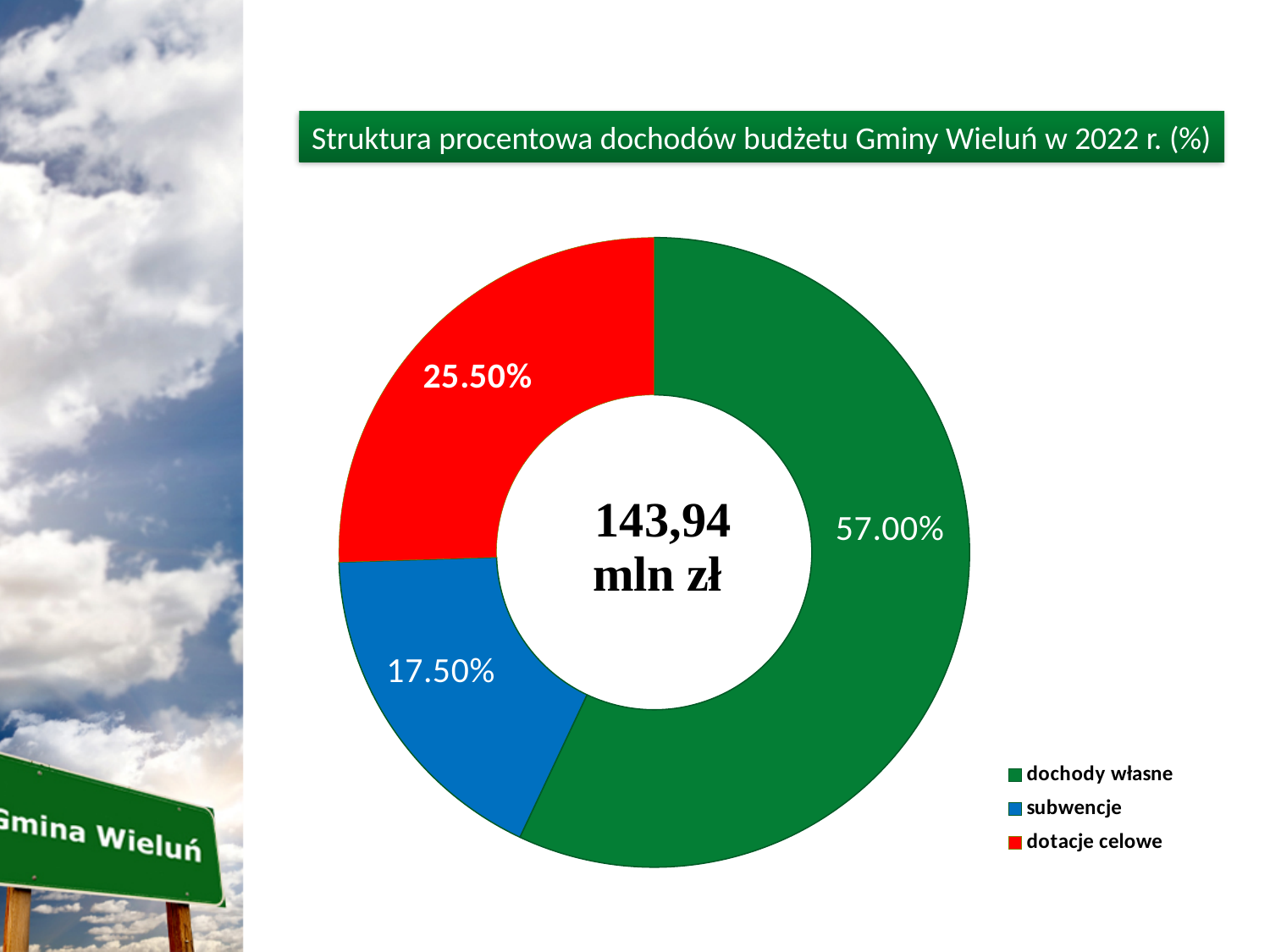
What colour represents 'subwencje' in the chart? blue Which category has the smallest share of the budget income? subwencje Which is larger: the share for 'subwencje' or for 'dotacje celowe'? dotacje celowe What is the difference in percentage points between 'dochody własne' and 'dotacje celowe'? 31.50 What kind of chart is shown on the slide? pie chart (doughnut) What share of the budget income is 'dochody własne'? 57.00% What share of the budget income is 'dotacje celowe'? 25.50% Which category has the largest share of the budget income? dochody własne What total amount is printed in the centre of the chart? 143,94 mln zł How many categories does the chart show? 3 What share of the budget income is 'subwencje'? 17.50% What is the difference in percentage points between 'dotacje celowe' and 'subwencje'? 8.00